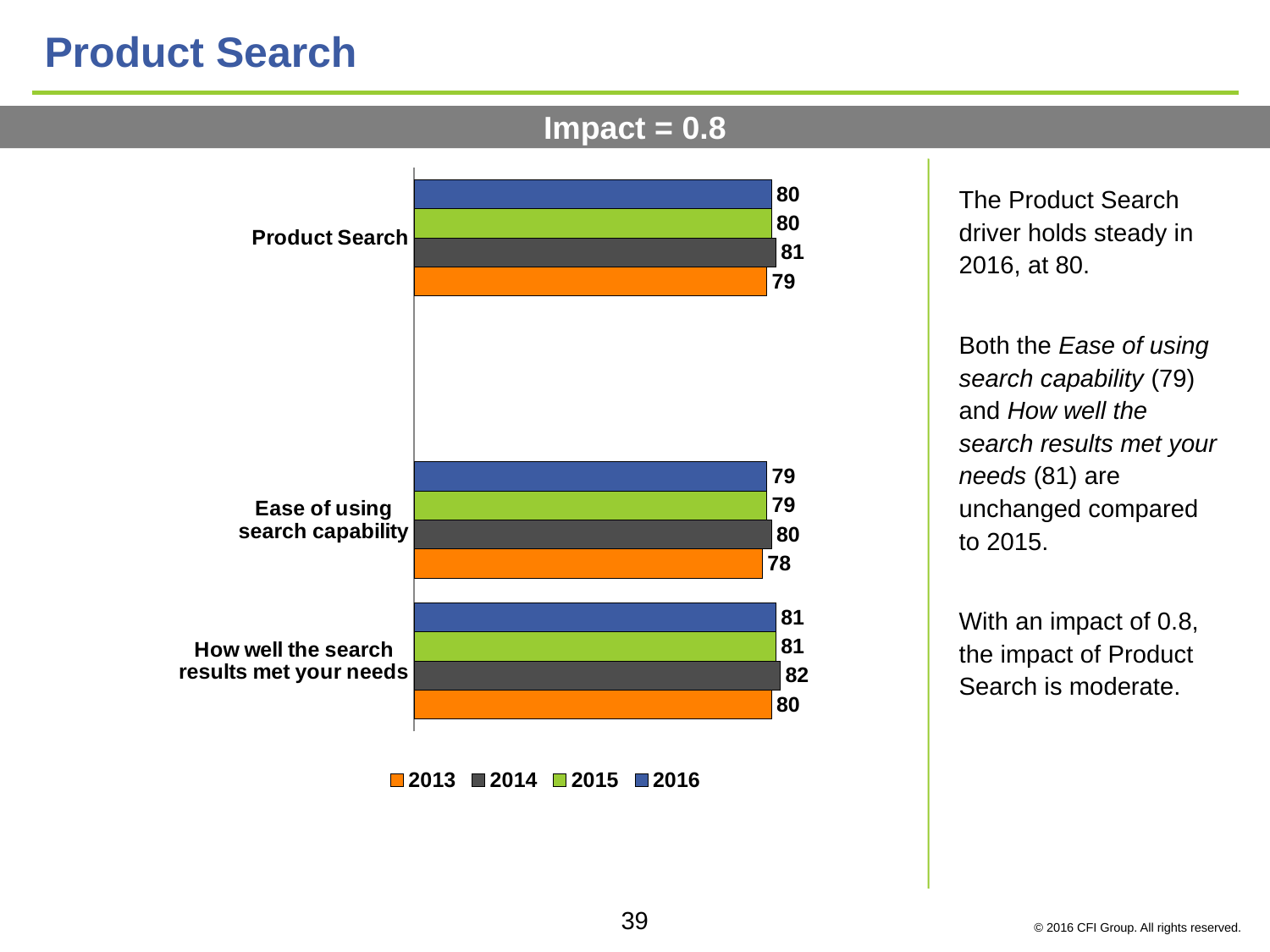
What is the difference between the 2014 and 2013 values for Product Search? 2 How many series does the legend list? 4 What is the 2013 value for Ease of using search capability? 78 How many categories are shown on the chart? 3 Which colour represents the 2015 series in the legend? Green Which category has the lowest 2013 value? Ease of using search capability What is the 2015 value for Ease of using search capability? 79 What is the 2016 value for Product Search? 80 Which category has the highest 2016 value? How well the search results met your needs What is the 2014 value for How well the search results met your needs? 82 What kind of chart is shown on the slide? Bar chart Which is larger for How well the search results met your needs: the 2014 value or the 2016 value? 2014